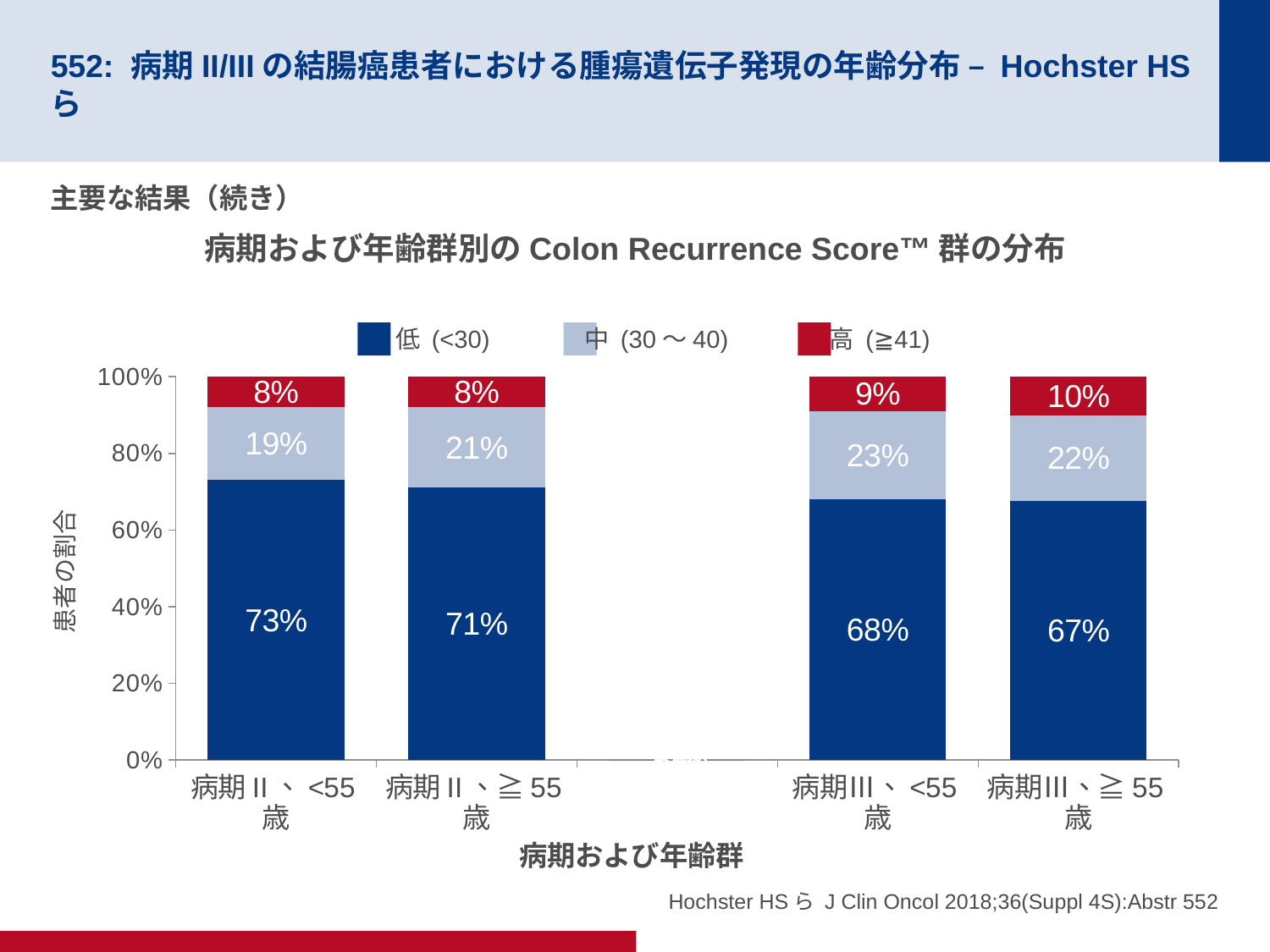
How many categories are shown on the x axis? 4 What is the value of 高 (≧41) for 病期III、≧55 歳? 10% What is the difference between the 低 (<30) values for 病期 II、<55 歳 and 病期III、≧55 歳? 6% How many series does the legend list? 3 Which is larger, the 中 (30～40) value for 病期 II、≧55 歳 or for 病期III、<55 歳? 病期III、<55 歳 Which category has the lowest value for 低 (<30)? 病期III、≧55 歳 Which category has the highest value for 低 (<30)? 病期 II、<55 歳 What type of chart is shown on the slide? stacked bar chart What is the value of 中 (30～40) for 病期III、<55 歳? 23% What is the title of the chart? 病期および年齢群別の Colon Recurrence Score™ 群の分布 What is the value of 低 (<30) for 病期 II、<55 歳? 73% What is the total of the stacked bar for 病期 II、≧55 歳? 100%